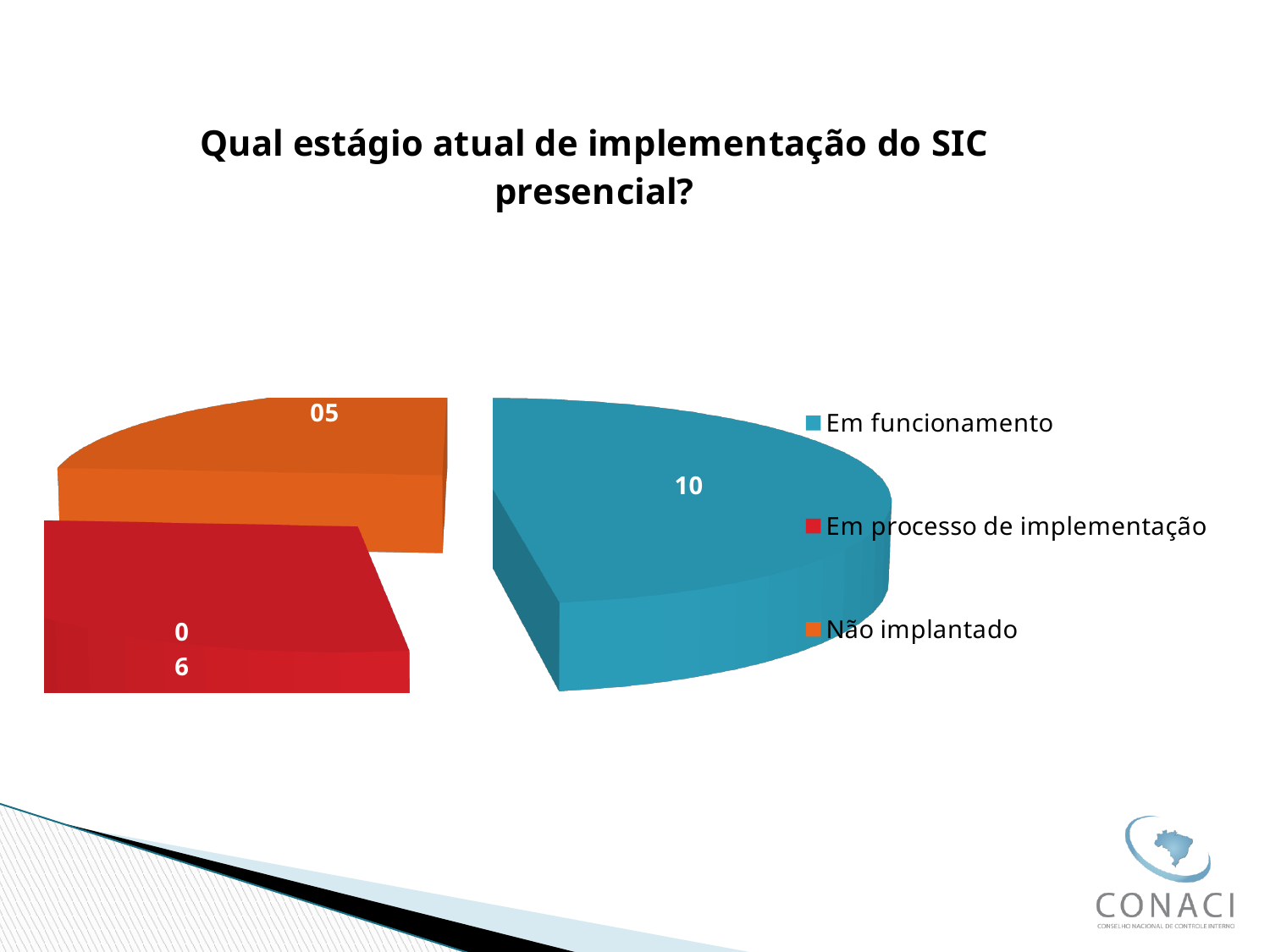
What is the difference between the values for "Em funcionamento" and "Não implantado"? 5 What kind of chart is shown on the slide? pie chart What colour is the "Em funcionamento" slice? blue Which is larger, the value for "Em funcionamento" or the value for "Em processo de implementação"? Em funcionamento What value is shown for the "Em funcionamento" slice? 10 How many slices does the pie chart have? 3 What value is shown for the "Em processo de implementação" slice? 06 Which category has the smallest slice of the pie? Não implantado How many entries does the legend list? 3 What is the title of the chart? Qual estágio atual de implementação do SIC presencial? Which category has the largest slice of the pie? Em funcionamento What value is shown for the "Não implantado" slice? 05